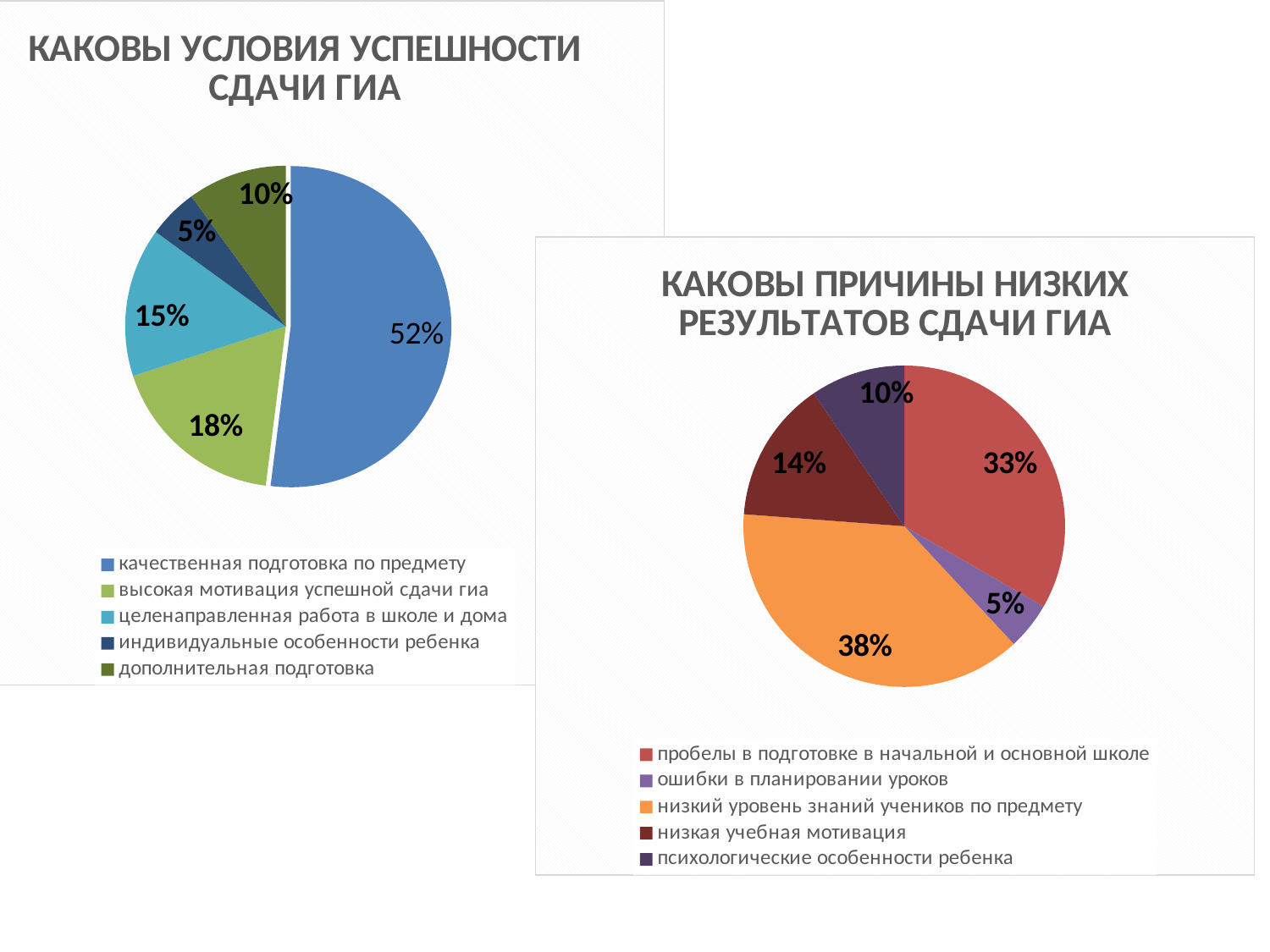
In the chart titled 'КАКОВЫ УСЛОВИЯ УСПЕШНОСТИ СДАЧИ ГИА', what is the difference between 'высокая мотивация успешной сдачи гиа' and 'дополнительная подготовка'? 8% In the chart titled 'КАКОВЫ ПРИЧИНЫ НИЗКИХ РЕЗУЛЬТАТОВ СДАЧИ ГИА', what share does 'низкая учебная мотивация' have? 14% What type of chart is the one titled 'КАКОВЫ ПРИЧИНЫ НИЗКИХ РЕЗУЛЬТАТОВ СДАЧИ ГИА'? pie chart In the chart titled 'КАКОВЫ ПРИЧИНЫ НИЗКИХ РЕЗУЛЬТАТОВ СДАЧИ ГИА', which category has the largest slice? низкий уровень знаний учеников по предмету In the chart titled 'КАКОВЫ УСЛОВИЯ УСПЕШНОСТИ СДАЧИ ГИА', how many categories does the legend list? 5 In the chart titled 'КАКОВЫ ПРИЧИНЫ НИЗКИХ РЕЗУЛЬТАТОВ СДАЧИ ГИА', what colour is the slice for 'низкий уровень знаний учеников по предмету'? orange In the chart titled 'КАКОВЫ ПРИЧИНЫ НИЗКИХ РЕЗУЛЬТАТОВ СДАЧИ ГИА', which is larger: 'пробелы в подготовке в начальной и основной школе' or 'психологические особенности ребенка'? пробелы в подготовке в начальной и основной школе In the chart titled 'КАКОВЫ ПРИЧИНЫ НИЗКИХ РЕЗУЛЬТАТОВ СДАЧИ ГИА', what share does 'низкий уровень знаний учеников по предмету' have? 38% In the chart titled 'КАКОВЫ ПРИЧИНЫ НИЗКИХ РЕЗУЛЬТАТОВ СДАЧИ ГИА', what is the difference between 'низкий уровень знаний учеников по предмету' and 'пробелы в подготовке в начальной и основной школе'? 5% In the chart titled 'КАКОВЫ УСЛОВИЯ УСПЕШНОСТИ СДАЧИ ГИА', what share does 'целенаправленная работа в школе и дома' have? 15% In the chart titled 'КАКОВЫ УСЛОВИЯ УСПЕШНОСТИ СДАЧИ ГИА', which category has the smallest slice? индивидуальные особенности ребенка In the chart titled 'КАКОВЫ УСЛОВИЯ УСПЕШНОСТИ СДАЧИ ГИА', what share does 'качественная подготовка по предмету' have? 52%